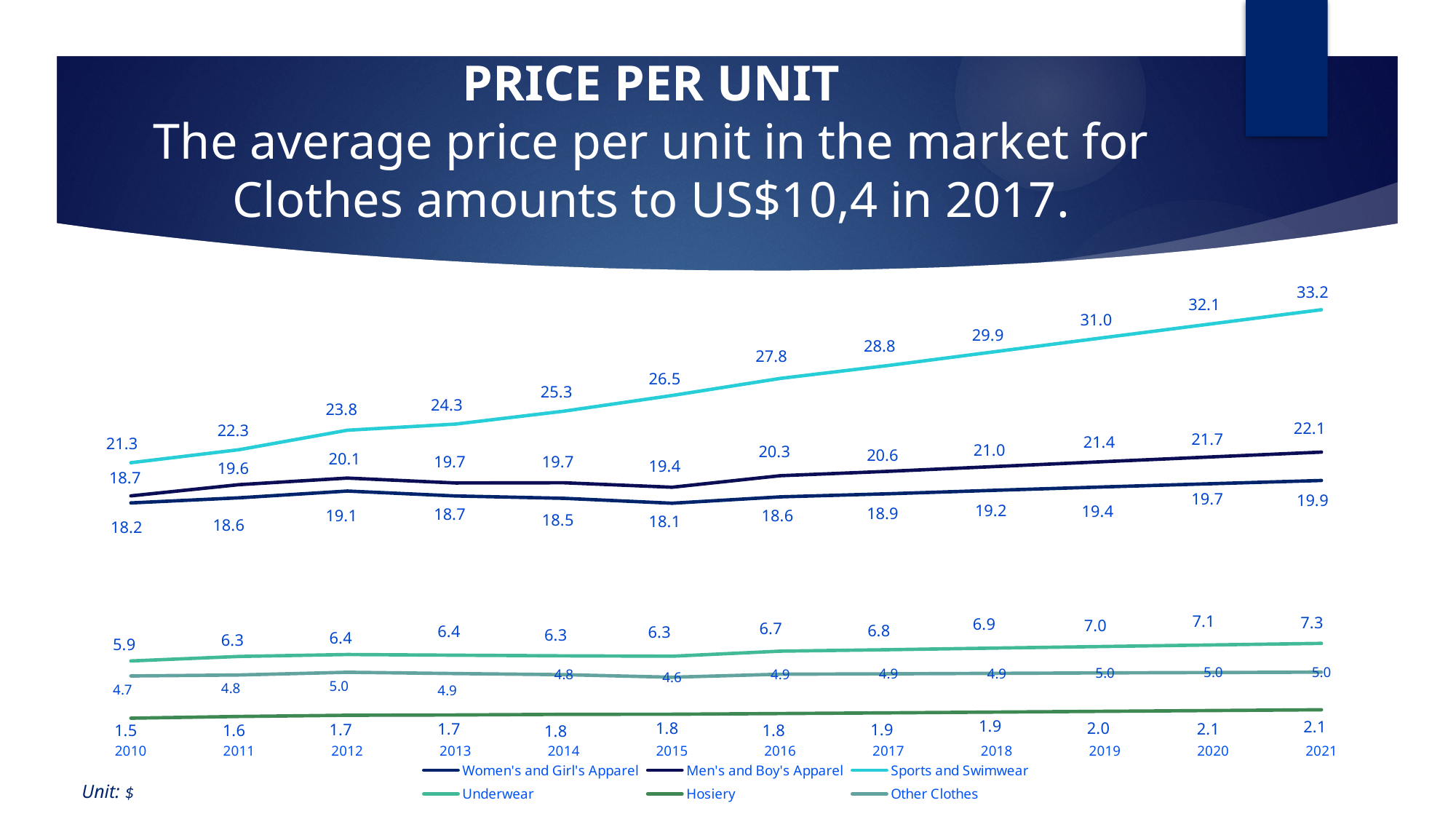
What is the price per unit for Other Clothes in 2015? 4.6 What kind of chart is shown on the slide? Line chart What is the price per unit for Sports and Swimwear in 2017? 28.8 What is the price per unit for Hosiery in 2010? 1.5 How many years are shown on the x axis of the chart? 12 In 2010, which is higher: the price per unit for Underwear or for Other Clothes? Underwear How many series does the legend list? 6 Which series has the lowest price per unit across all years shown? Hosiery Which series has the highest price per unit in 2021? Sports and Swimwear What is the price per unit for Underwear in 2021? 7.3 What is the difference between the Hosiery price per unit in 2021 and in 2010? 0.6 By how much did the price per unit for Sports and Swimwear increase from 2010 to 2021? 11.9